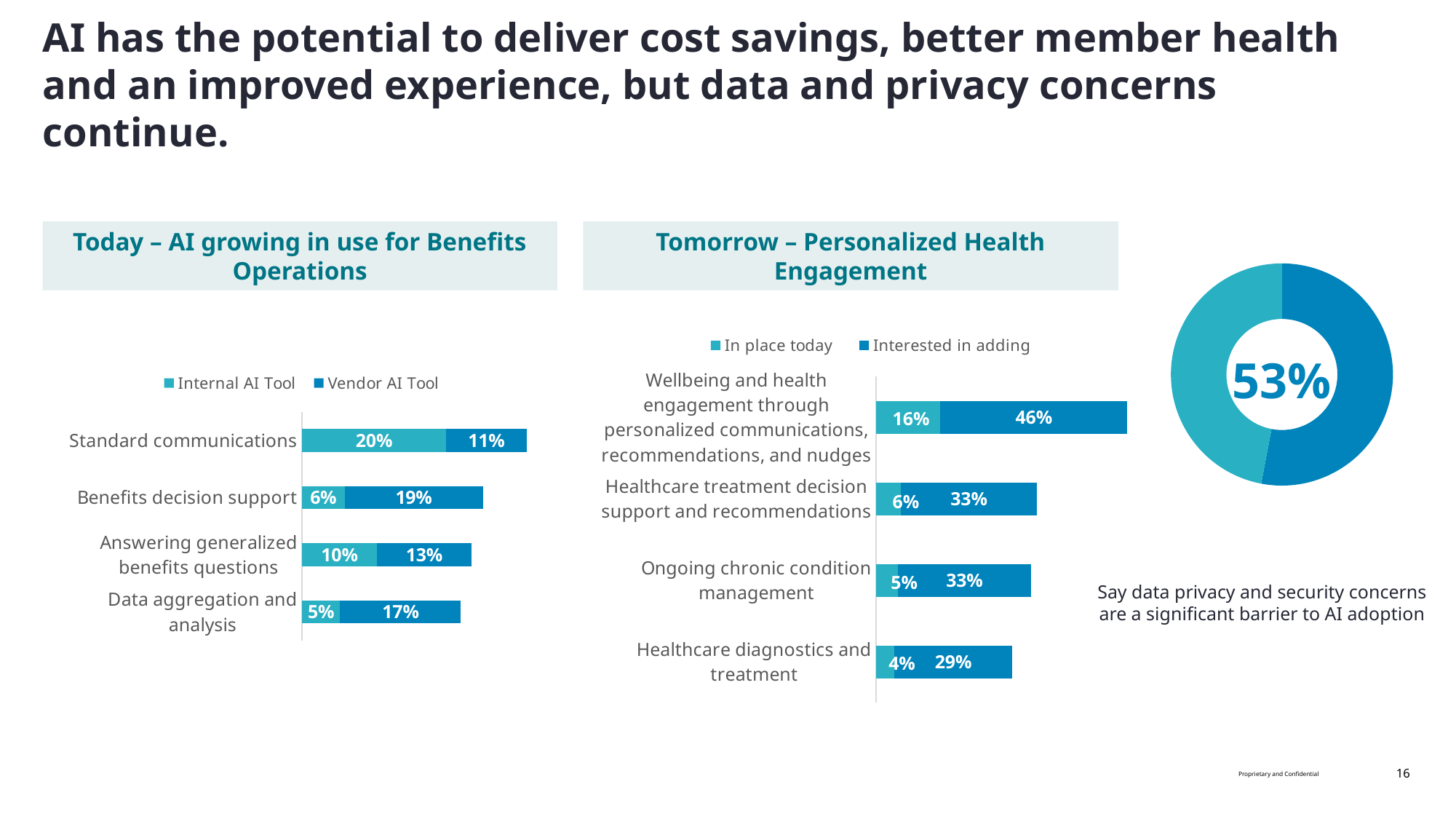
In the 'Today – AI growing in use for Benefits Operations' chart, what is the Internal AI Tool value for Standard communications? 20% In the 'Today – AI growing in use for Benefits Operations' chart, how many series does the legend list? 2 In the 'Today – AI growing in use for Benefits Operations' chart, which category has the highest Internal AI Tool value? Standard communications What percentage is shown in the centre of the donut chart on the right of the slide? 53% In the 'Tomorrow – Personalized Health Engagement' chart, what is the 'In place today' value for Ongoing chronic condition management? 5% In the 'Today – AI growing in use for Benefits Operations' chart, what is the total of the stacked bar for Data aggregation and analysis? 22% What kind of chart is the 'Today – AI growing in use for Benefits Operations' chart? Stacked bar chart In the 'Tomorrow – Personalized Health Engagement' chart, what is the 'Interested in adding' value for Healthcare diagnostics and treatment? 29% In the 'Tomorrow – Personalized Health Engagement' chart, what is the difference between the 'Interested in adding' values for Wellbeing and health engagement through personalized communications, recommendations, and nudges and for Healthcare diagnostics and treatment? 17% In the 'Tomorrow – Personalized Health Engagement' chart, which category has the lowest 'In place today' value? Healthcare diagnostics and treatment In the 'Today – AI growing in use for Benefits Operations' chart, what is the Vendor AI Tool value for Benefits decision support? 19% In the 'Tomorrow – Personalized Health Engagement' chart, how many categories are plotted? 4